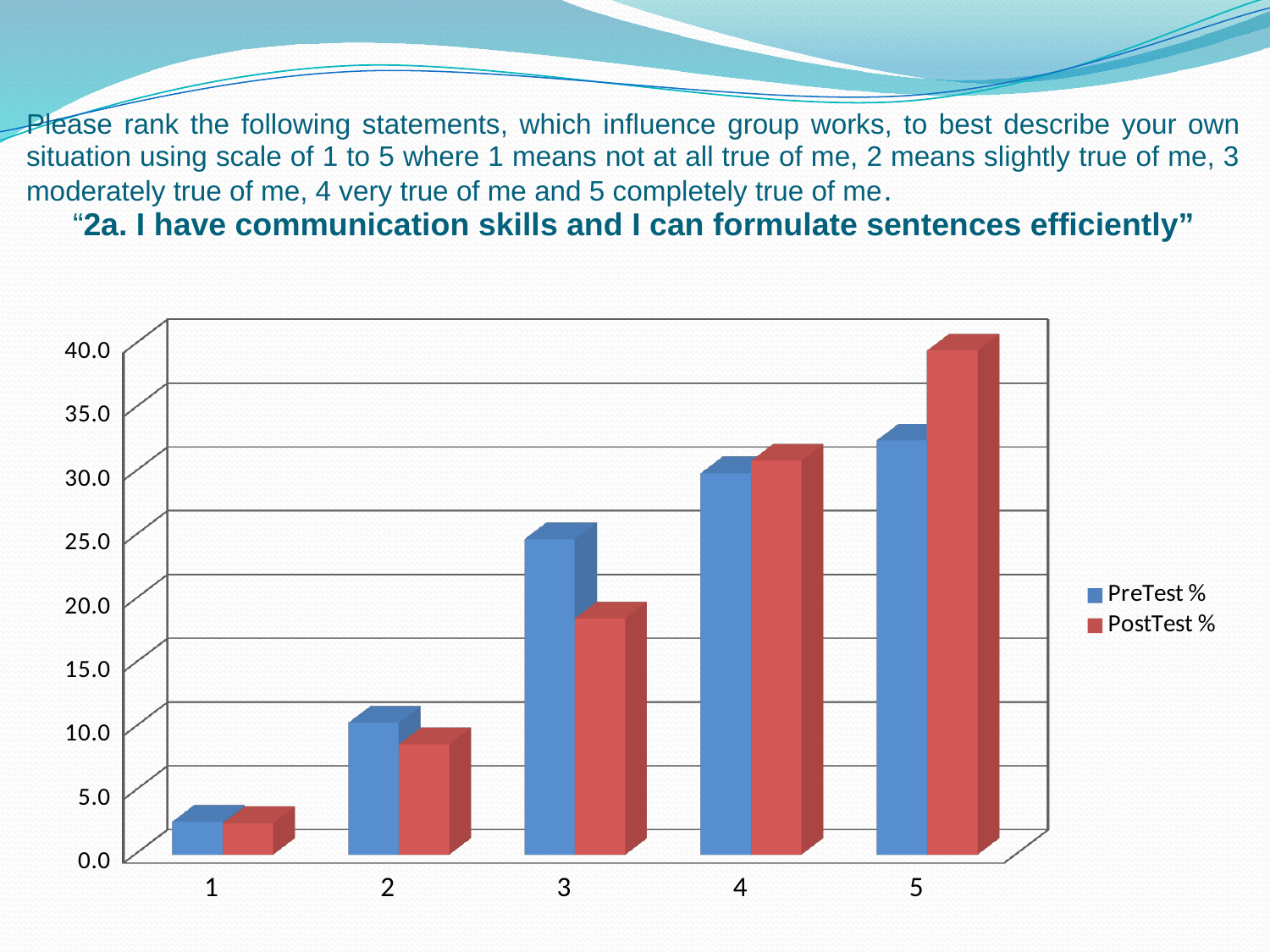
For category 5, which series has the larger value, PreTest % or PostTest %? PostTest % What kind of chart is shown on the slide? bar chart Is the PreTest % value for category 3 greater or less than 20.0? greater How many categories are shown on the x axis? 5 How many series does the legend list? 2 Is the PreTest % value for category 1 greater or less than 5.0? less Is the PostTest % value for category 3 greater or less than 20.0? less Which category has the lowest PreTest % value? 1 Which category has the highest PostTest % value? 5 For category 3, which series has the larger value, PreTest % or PostTest %? PreTest % Do the PostTest % values rise or fall from category 1 to category 5? rise